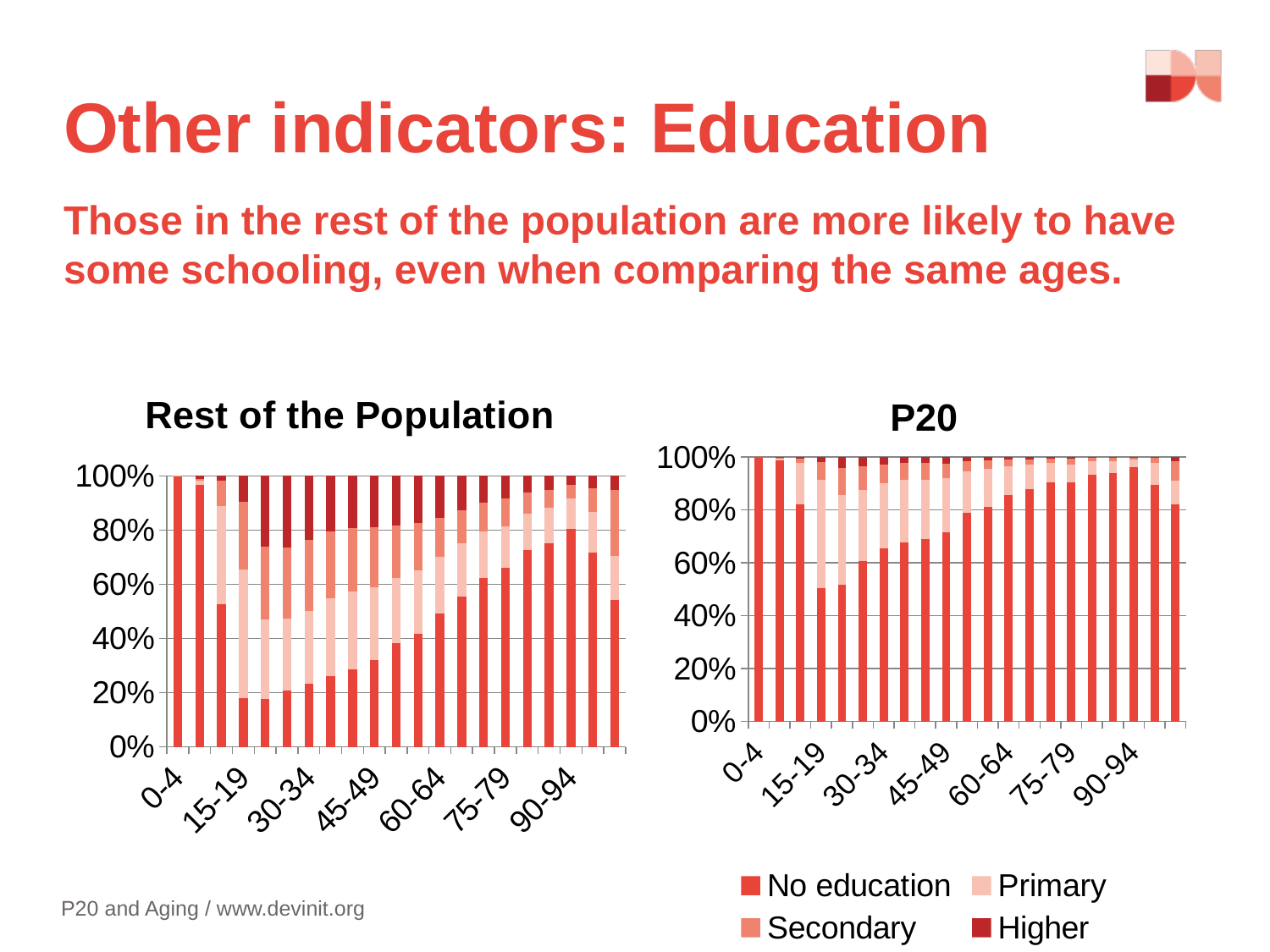
How many series does the legend list? 4 What are the four education categories listed in the legend? No education, Primary, Secondary, Higher What kind of chart is the "Rest of the Population" chart? Stacked bar chart What are the titles of the two charts on the slide? Rest of the Population and P20 In the "P20" chart, is the No education share for the 15-19 age group greater or less than 40%? greater In the "Rest of the Population" chart, is the No education share for the 15-19 age group greater or less than 20%? less In the "Rest of the Population" chart, is the No education share for the 45-49 age group greater or less than 40%? less In the "P20" chart, does the No education share generally rise or fall as age increases from 15-19 to 90-94? Rise Which chart shows a larger No education share for the 30-34 age group, "Rest of the Population" or "P20"? P20 In the "Rest of the Population" chart, does the No education share generally rise or fall as age increases from 15-19 to 90-94? Rise